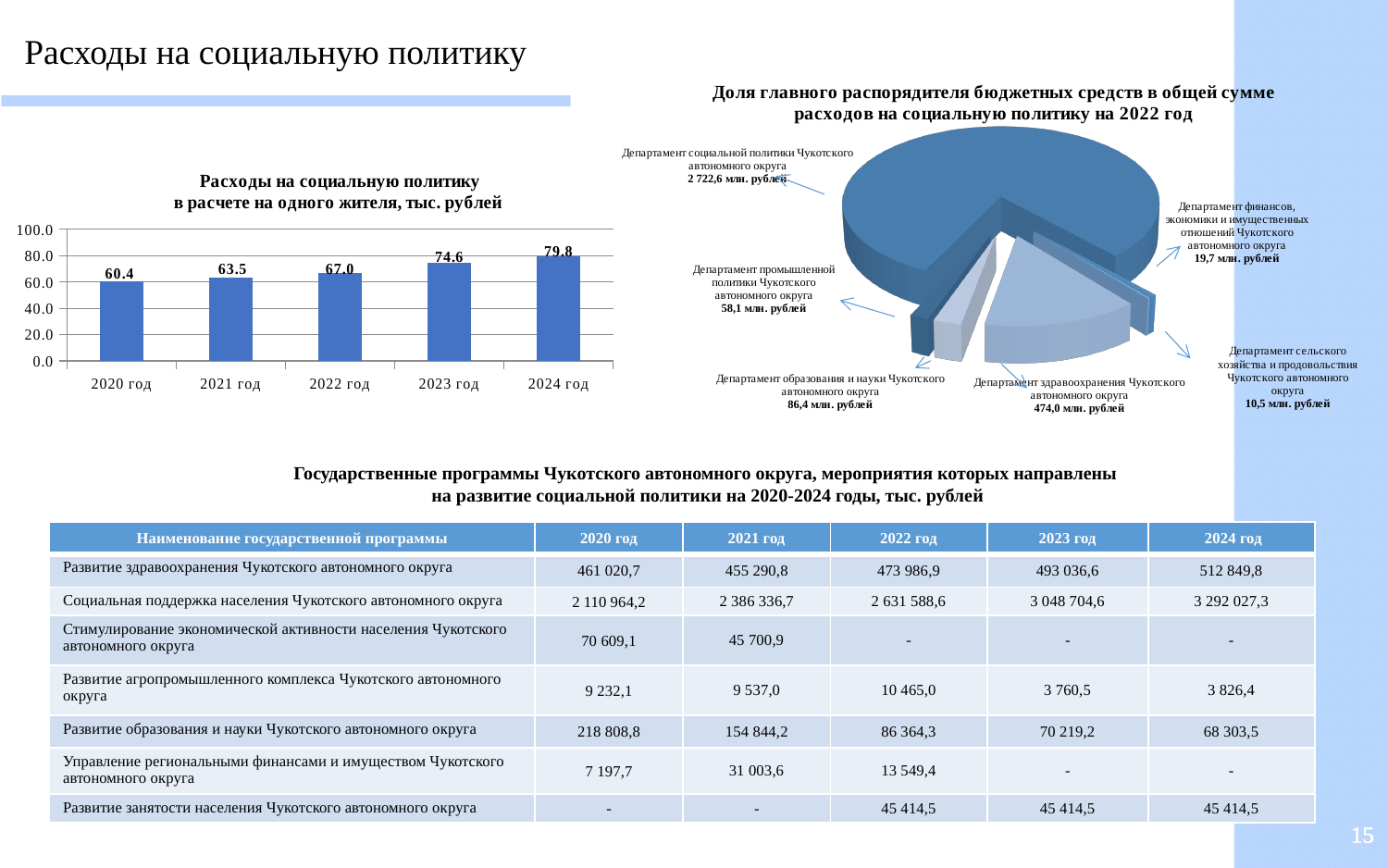
In the bar chart 'Расходы на социальную политику в расчете на одного жителя, тыс. рублей', which year has the lowest value? 2020 год In the bar chart 'Расходы на социальную политику в расчете на одного жителя, тыс. рублей', what is the value for 2020 год? 60.4 What kind of chart is 'Расходы на социальную политику в расчете на одного жителя, тыс. рублей'? bar chart In the bar chart 'Расходы на социальную политику в расчете на одного жителя, тыс. рублей', what is the value for 2023 год? 74.6 In the pie chart 'Доля главного распорядителя бюджетных средств в общей сумме расходов на социальную политику на 2022 год', which is larger: the value for Департамент образования и науки or for Департамент промышленной политики? Департамент образования и науки In the bar chart 'Расходы на социальную политику в расчете на одного жителя, тыс. рублей', what is the difference between the values for 2024 год and 2020 год? 19.4 In the pie chart 'Доля главного распорядителя бюджетных средств в общей сумме расходов на социальную политику на 2022 год', what is the value for Департамент здравоохранения Чукотского автономного округа? 474,0 млн. рублей In the pie chart 'Доля главного распорядителя бюджетных средств в общей сумме расходов на социальную политику на 2022 год', what is the value for Департамент социальной политики Чукотского автономного округа? 2 722,6 млн. рублей In the bar chart 'Расходы на социальную политику в расчете на одного жителя, тыс. рублей', which year has the highest value? 2024 год In the pie chart 'Доля главного распорядителя бюджетных средств в общей сумме расходов на социальную политику на 2022 год', which department has the smallest value? Департамент сельского хозяйства и продовольствия Чукотского автономного округа In the bar chart 'Расходы на социальную политику в расчете на одного жителя, тыс. рублей', do the values rise or fall from 2020 год to 2024 год? rise How many years are shown in the bar chart 'Расходы на социальную политику в расчете на одного жителя, тыс. рублей'? 5